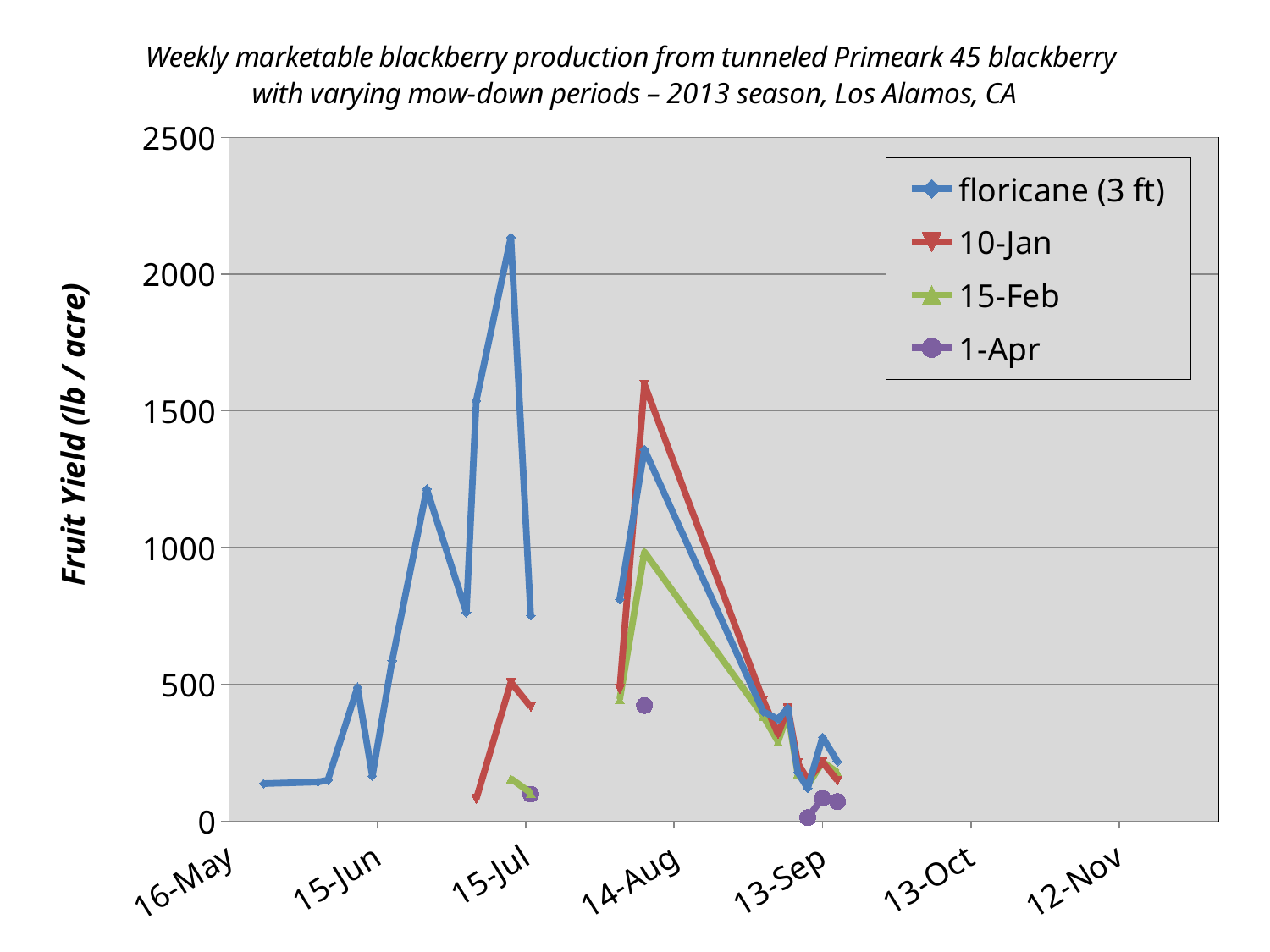
Is the first plotted value for floricane (3 ft) near 16-May greater or less than 500? less Is the highest value for 10-Jan greater or less than 1500? greater Which series has the lowest peak yield on the chart? 1-Apr Is the highest value for 1-Apr greater or less than 500? less What is the label on the vertical axis? Fruit Yield (lb / acre) How many date labels are shown on the horizontal axis? 7 Which series is plotted with purple circle markers? 1-Apr Which series reaches the highest peak yield on the chart? floricane (3 ft) Around mid-August, which series has the higher peak, 10-Jan or 15-Feb? 10-Jan What kind of chart is shown on the slide? line chart How many series does the legend list? 4